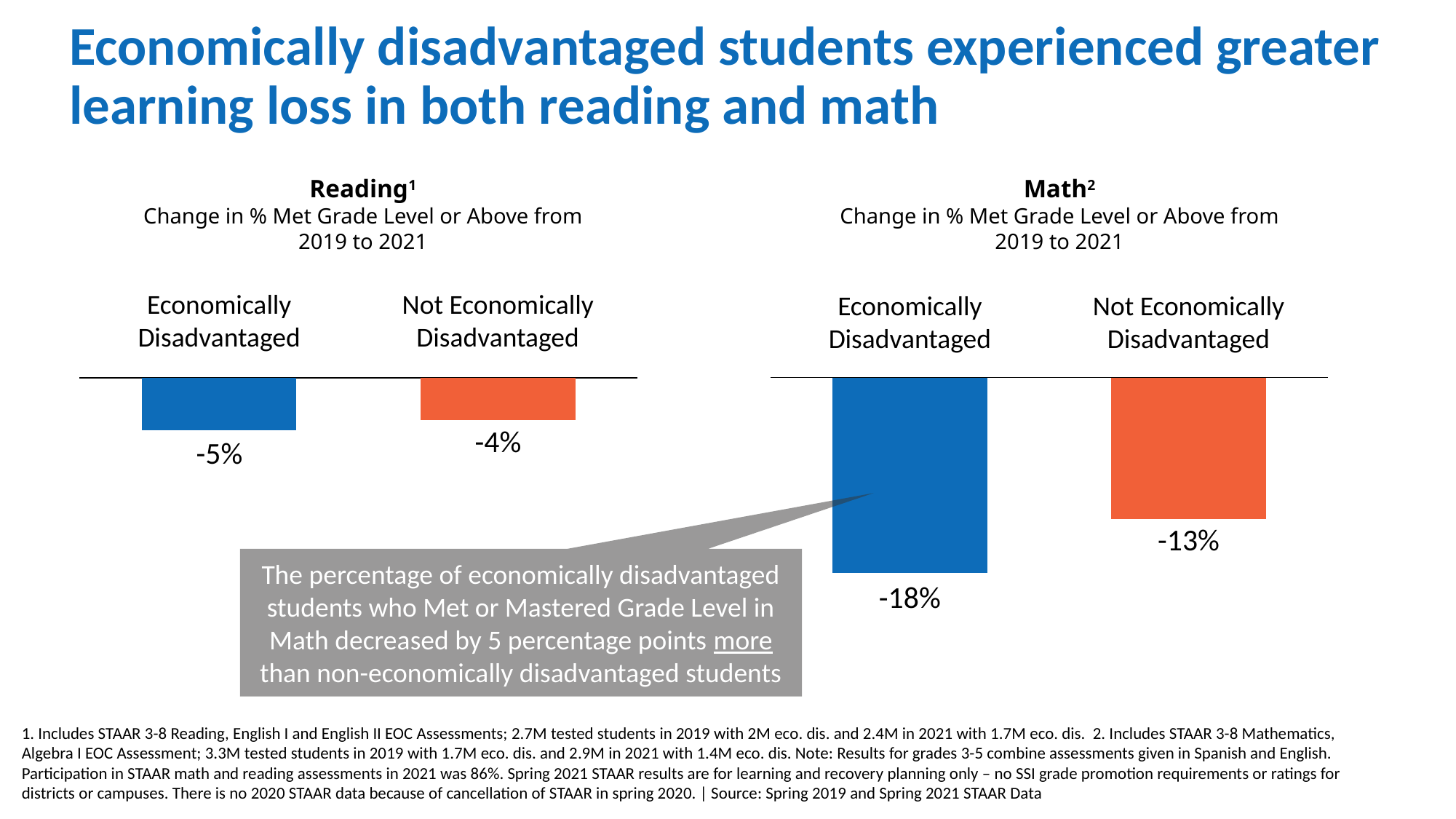
Is the decrease for Economically Disadvantaged students larger in the Reading chart or the Math chart? Math In the Math chart, what is the value for Economically Disadvantaged? -18% How many categories are shown in the Math chart? 2 In the Reading chart, what is the difference in percentage points between the Economically Disadvantaged and Not Economically Disadvantaged values? 1 percentage point In the Reading chart, what is the value for Economically Disadvantaged? -5% In the Math chart, which category has the larger decrease? Economically Disadvantaged What type of chart is the Reading chart? Bar chart In the Math chart, what is the value for Not Economically Disadvantaged? -13% In the Math chart, what is the difference in percentage points between the Economically Disadvantaged and Not Economically Disadvantaged values? 5 percentage points In the Reading chart, which category has the smaller decrease? Not Economically Disadvantaged In the Reading chart, what is the value for Not Economically Disadvantaged? -4% What is the subtitle shown under the Math chart title? Change in % Met Grade Level or Above from 2019 to 2021